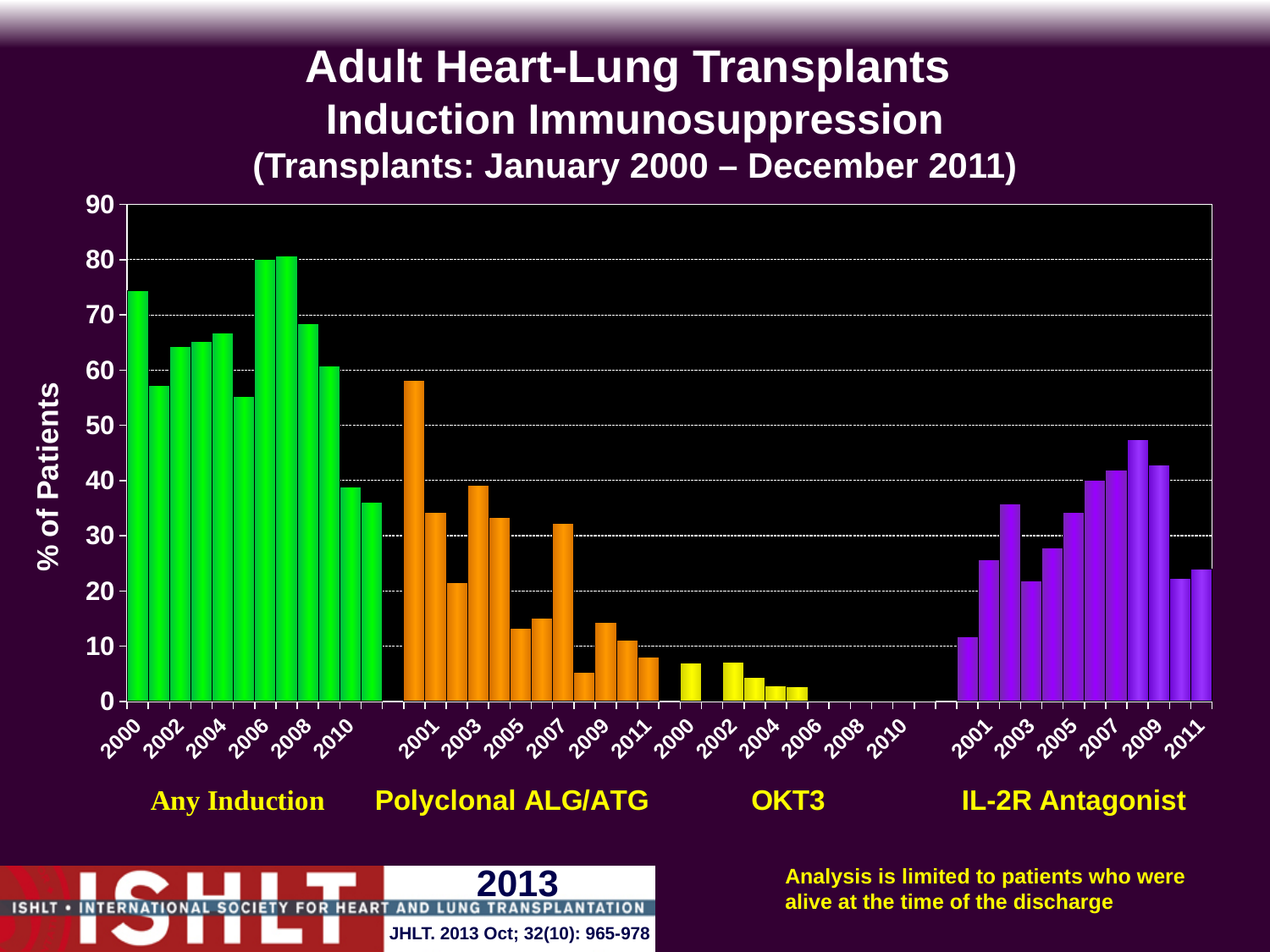
In which year is the IL-2R Antagonist value highest? 2008 In which year is the Any Induction value lowest? 2011 How many induction agent groups are shown along the x axis? 4 Is the value for Any Induction in 2000 greater or less than 70? greater In which year is the Polyclonal ALG/ATG value highest? 2000 Is the value for Polyclonal ALG/ATG in 2000 greater or less than 50? greater What is the label on the y axis? % of Patients Is the value for IL-2R Antagonist in 2008 greater or less than 40? greater Do the Polyclonal ALG/ATG values generally rise or fall from 2000 to 2011? fall Which is larger in 2006: the Any Induction value or the Polyclonal ALG/ATG value? Any Induction What kind of chart is shown on the slide? bar chart